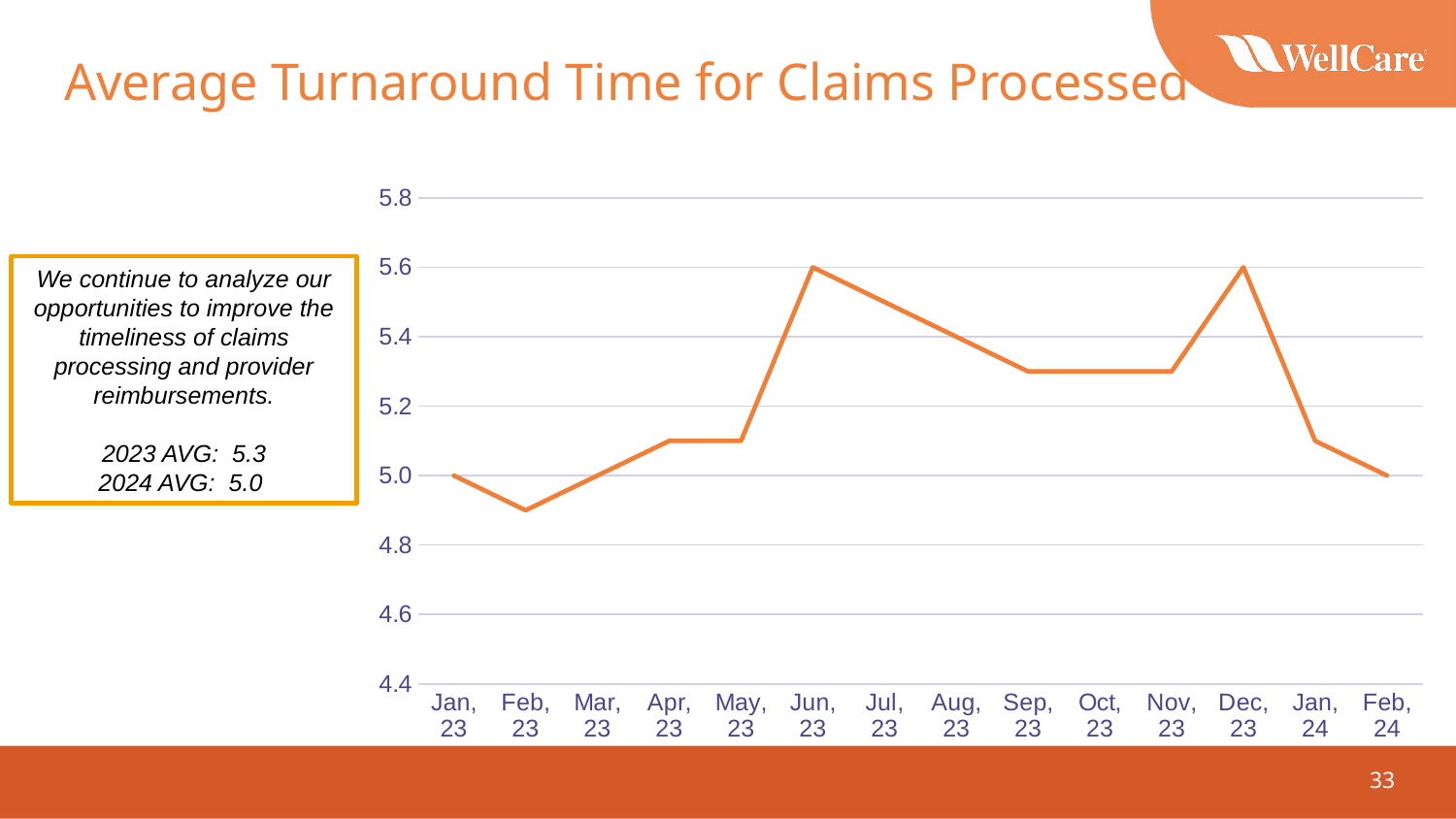
Which is larger, the value for Jun, 23 or the value for Jan, 24? Jun, 23 What is the title of the chart? Average Turnaround Time for Claims Processed What kind of chart is shown on the slide? line chart Do the values rise or fall from Jun, 23 to Sep, 23? fall Which month has the lowest value? Feb, 23 How many months are plotted on the x axis? 14 Is the value for Feb, 23 greater or less than 5.0? less What is the value for Jun, 23? 5.6 Is the value for Sep, 23 greater or less than 5.2? greater What is the value for Jan, 23? 5.0 What is the difference between the value for Jun, 23 and the value for Jan, 23? 0.6 What is the value for Feb, 24? 5.0